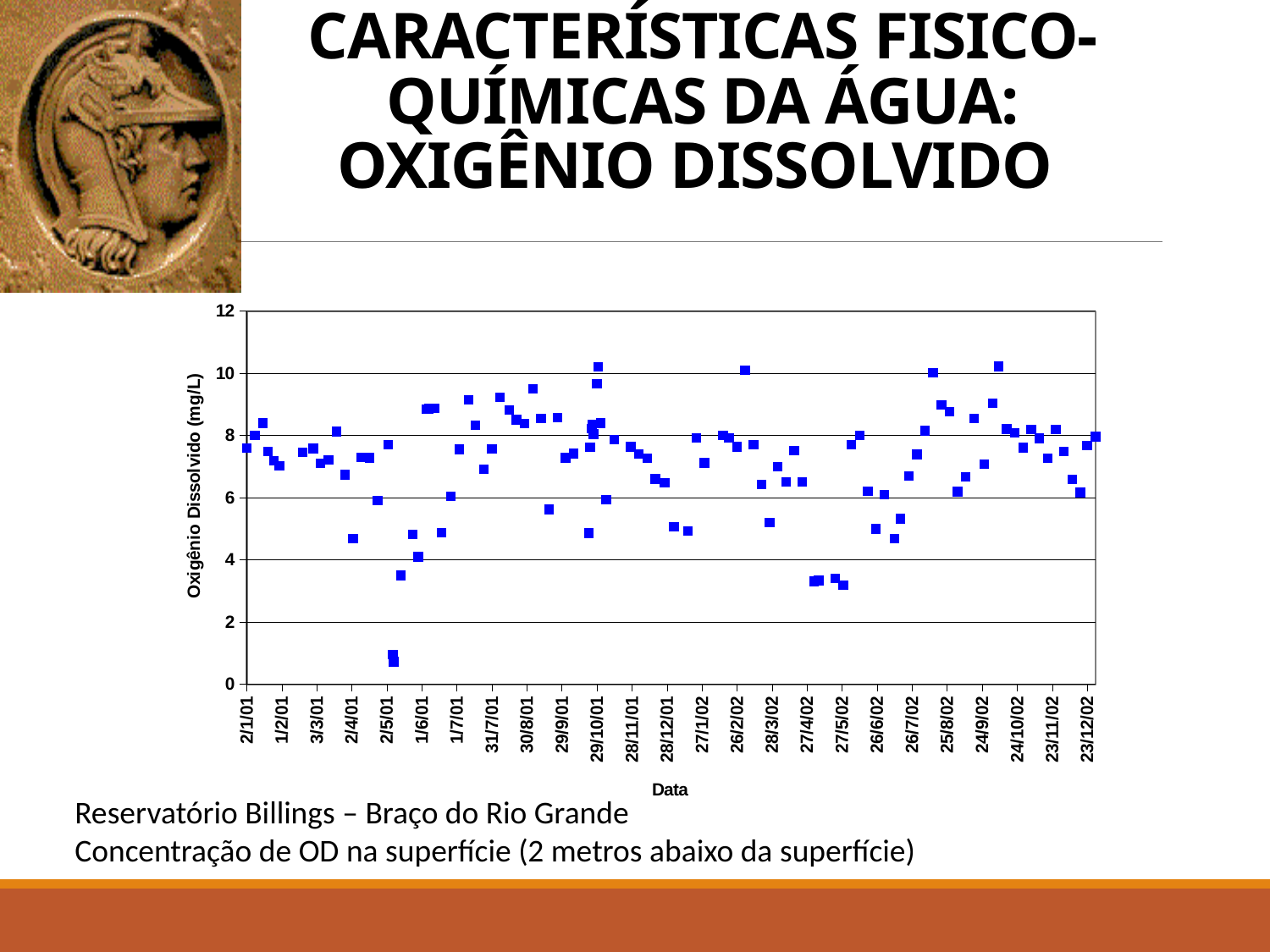
What is the highest value shown on the y axis of the chart? 12 Is the value plotted at 2/1/01 greater or less than 6? greater What is the label of the x axis of the chart? Data Is the highest plotted value in the chart greater or less than 10? greater What kind of chart is shown on the slide? scatter chart How many date labels are shown on the x axis of the chart? 25 What is the label of the y axis of the chart? Oxigênio Dissolvido (mg/L) What is the last date label on the x axis of the chart? 23/12/02 What is the first date label on the x axis of the chart? 2/1/01 Is the lowest plotted value in the chart greater or less than 2? less